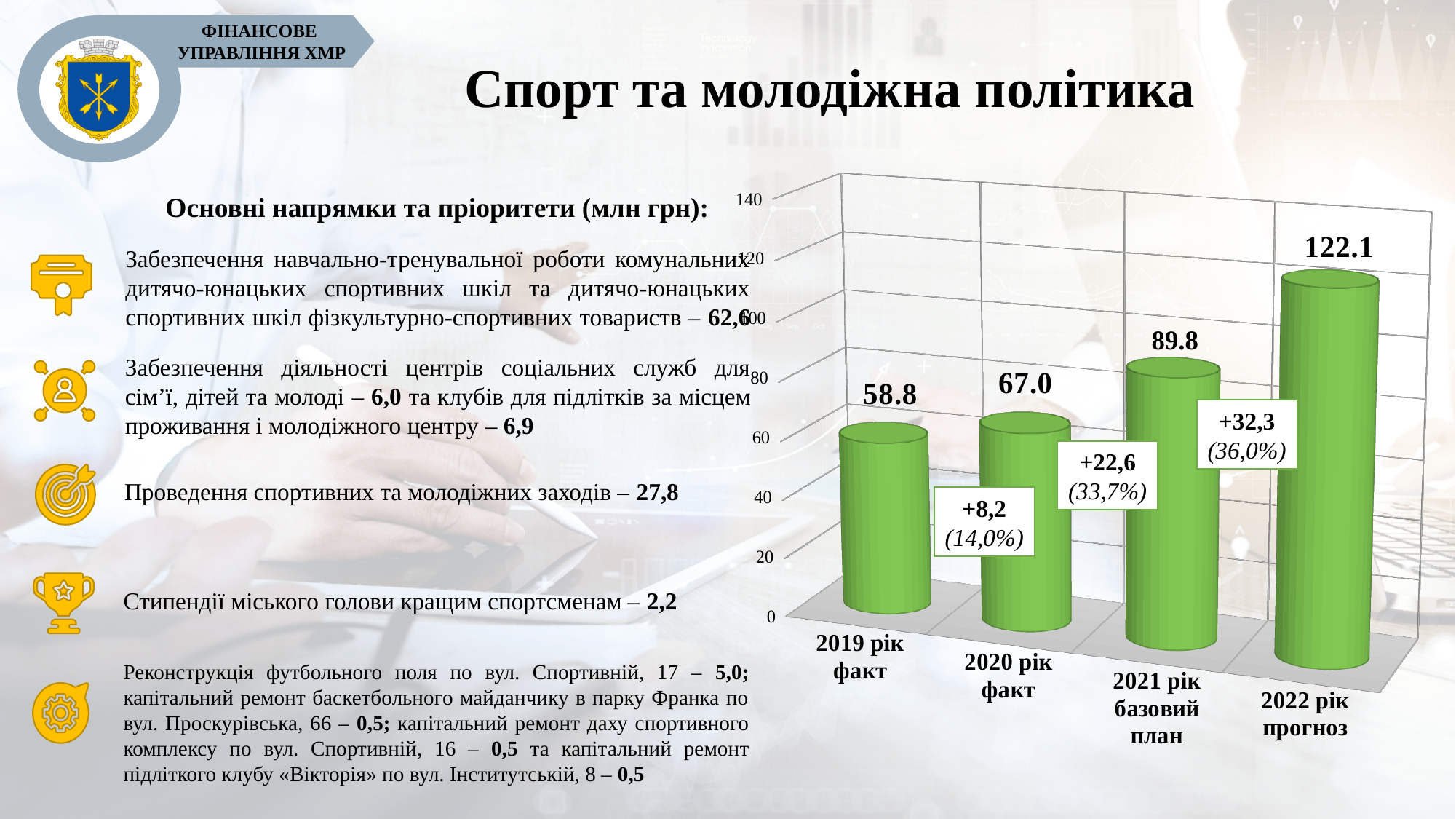
What is the value for 2021 рік базовий план? 89.8 Do the values rise or fall from 2019 рік факт to 2022 рік прогноз? rise How many categories are shown on the x axis of the chart? 4 What is the value for 2019 рік факт? 58.8 What is the difference between the values for 2022 рік прогноз and 2021 рік базовий план? 32.3 What kind of chart is shown on the slide? bar chart Which category has the lowest value? 2019 рік факт What is the value for 2022 рік прогноз? 122.1 Which category has the highest value? 2022 рік прогноз What is the value for 2020 рік факт? 67.0 Is the value for 2022 рік прогноз greater or less than 100? greater Which is larger, the value for 2020 рік факт or the value for 2021 рік базовий план? 2021 рік базовий план